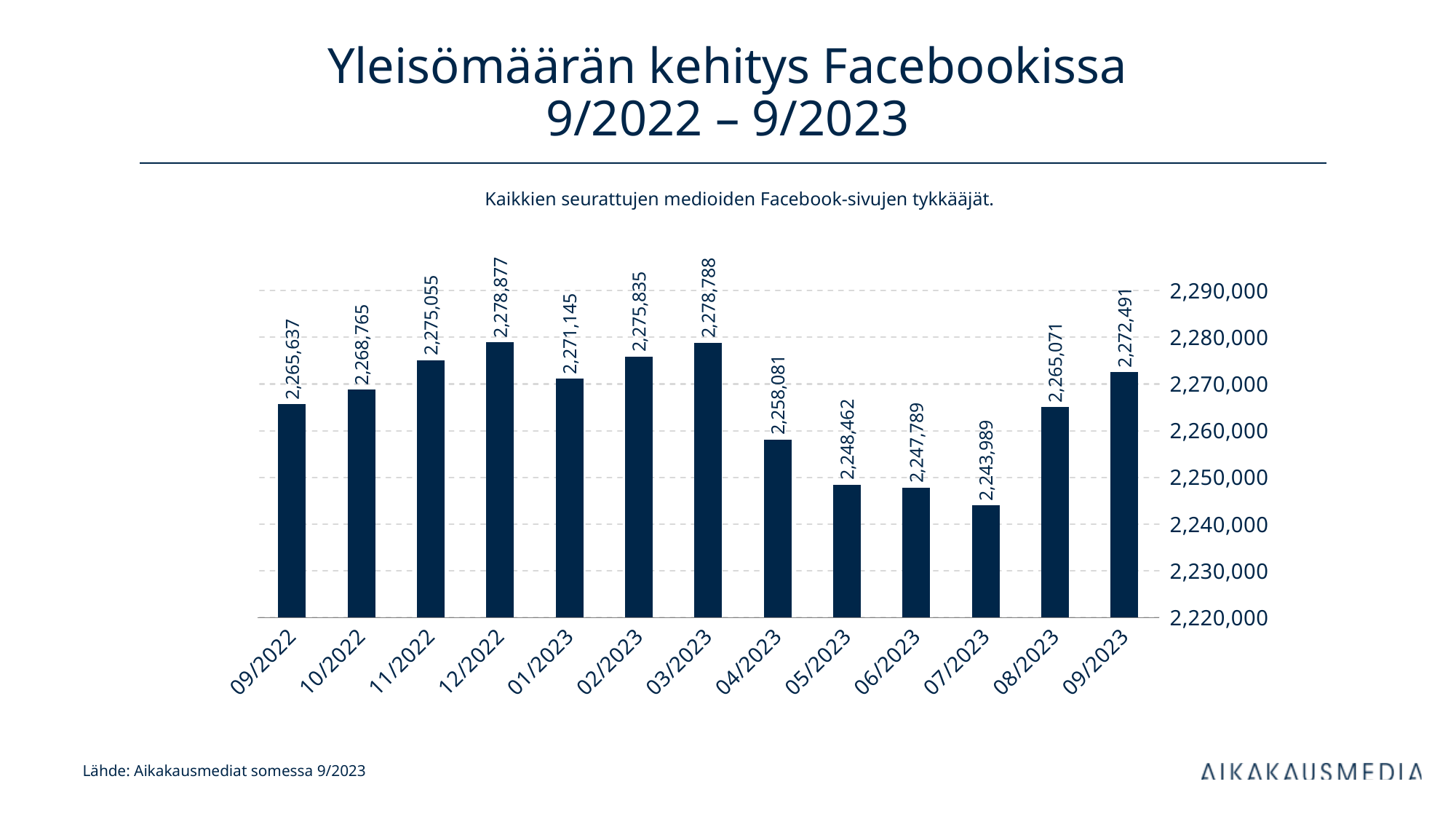
Is the value for 05/2023 greater or less than 2,250,000? less What is the value for 12/2022? 2,278,877 Which month has the highest value? 12/2022 What is the difference between the values for 09/2023 and 09/2022? 6,854 Which is larger, the value for 04/2023 or the value for 08/2023? 08/2023 What kind of chart is shown on the slide? bar chart Which month has the lowest value? 07/2023 What is the value for 07/2023? 2,243,989 What is the difference between the values for 12/2022 and 07/2023? 34,888 What is the value for 09/2023? 2,272,491 How many months are shown on the x axis? 13 Do the values rise or fall from 03/2023 to 07/2023? fall